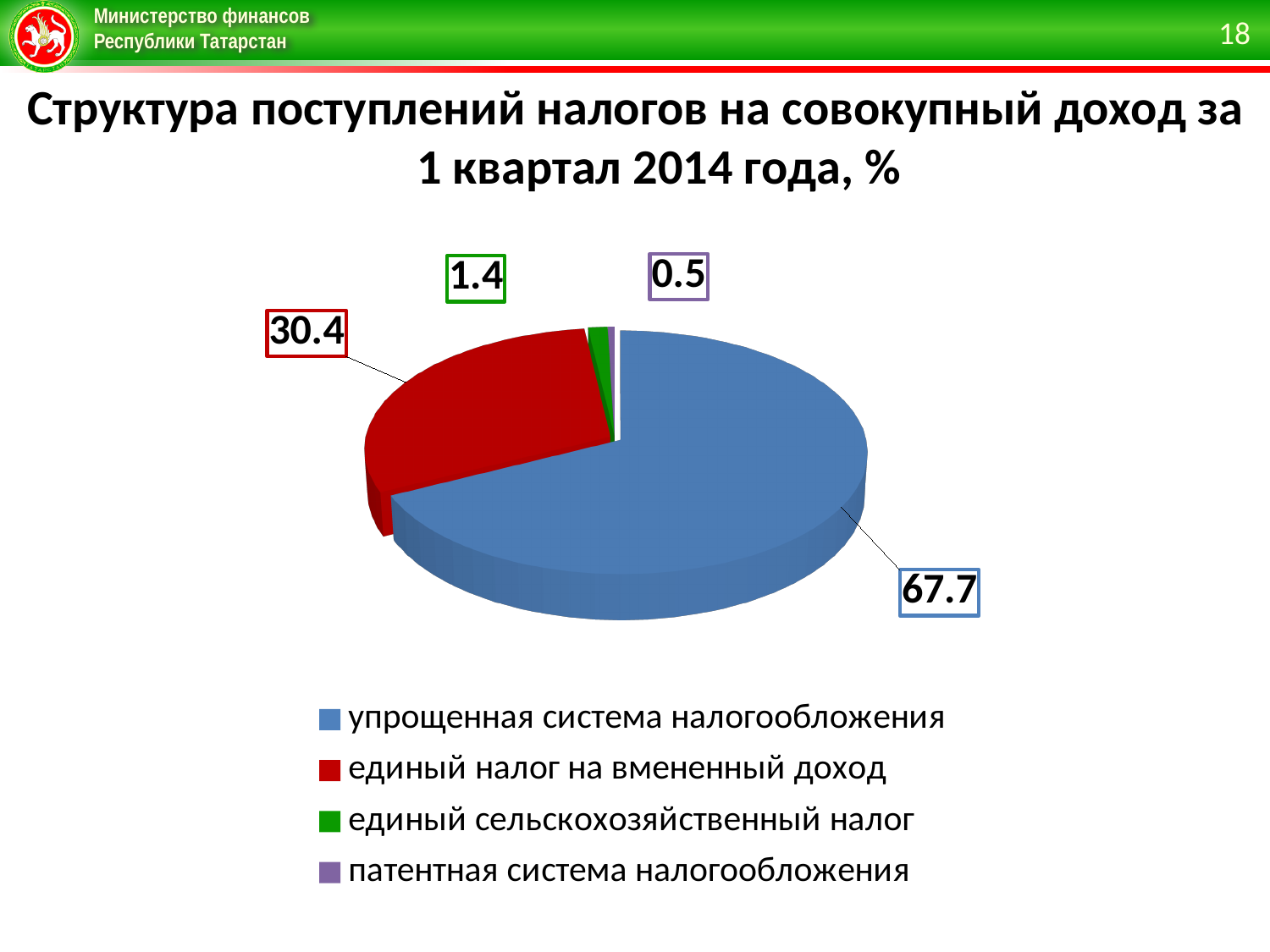
What is the value for упрощенная система налогообложения? 67.7 How many slices does the pie chart have? 4 What colour is the slice for единый налог на вмененный доход? red What is the difference between the values for упрощенная система налогообложения and единый налог на вмененный доход? 37.3 What is the value for единый сельскохозяйственный налог? 1.4 What is the value for патентная система налогообложения? 0.5 What is the title of the chart? Структура поступлений налогов на совокупный доход за 1 квартал 2014 года, % Which category has the largest share of the pie? упрощенная система налогообложения Which is larger: единый сельскохозяйственный налог or патентная система налогообложения? единый сельскохозяйственный налог Which category has the smallest share of the pie? патентная система налогообложения What kind of chart is shown on the slide? pie chart What is the value for единый налог на вмененный доход? 30.4